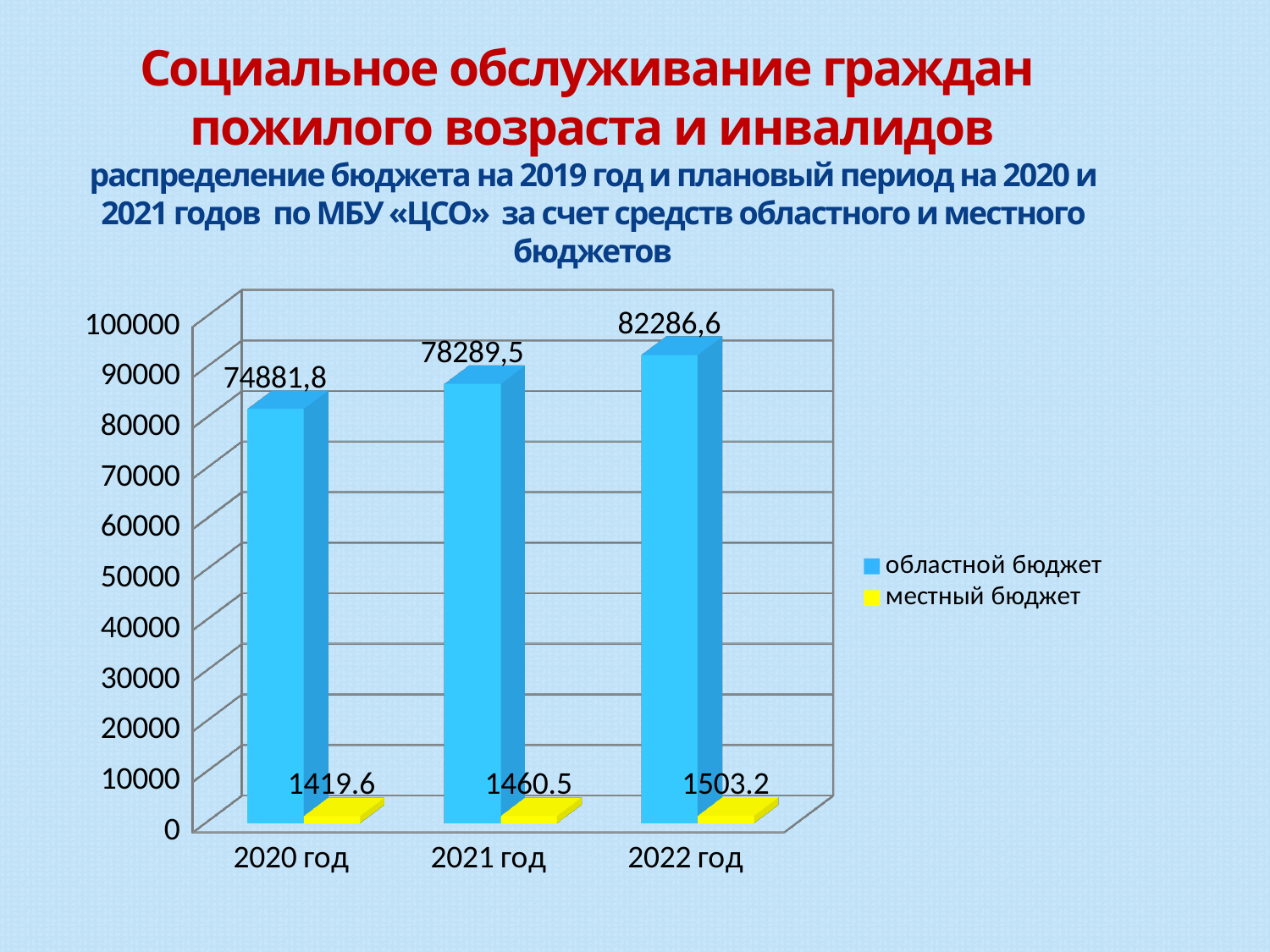
What is the value of местный бюджет for 2022 год? 1503.2 What is the value of областной бюджет for 2021 год? 78289,5 How many series does the legend list? 2 What is the difference between the областной бюджет values for 2021 год and 2020 год? 3407,7 Which is larger: областной бюджет for 2022 год or областной бюджет for 2020 год? областной бюджет for 2022 год How many years are shown on the x axis? 3 What is the difference between the местный бюджет values for 2022 год and 2021 год? 42.7 What is the value of областной бюджет for 2020 год? 74881,8 Is the value of областной бюджет for 2022 год greater or less than 80000? greater Do the областной бюджет values rise or fall from 2020 год to 2022 год? rise Which year has the lowest value for местный бюджет? 2020 год Which year has the highest value for областной бюджет? 2022 год